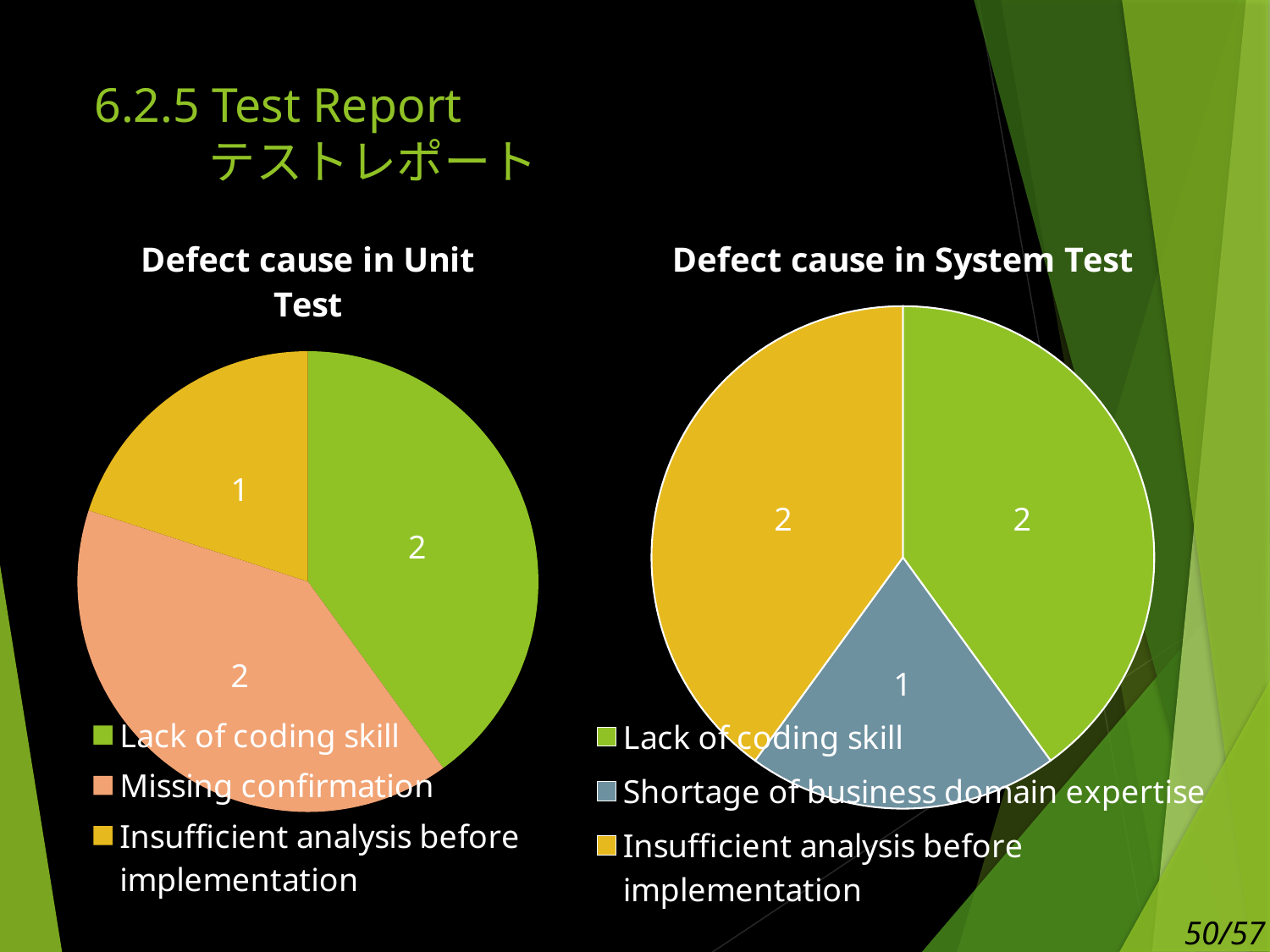
In the 'Defect cause in Unit Test' chart, what is the value for Lack of coding skill? 2 In the 'Defect cause in System Test' chart, what is the value for Shortage of business domain expertise? 1 In the 'Defect cause in Unit Test' chart, how many categories are shown? 3 In the 'Defect cause in Unit Test' chart, which colour represents Missing confirmation? Orange In the 'Defect cause in Unit Test' chart, what share of the total does Missing confirmation represent? 40% In the 'Defect cause in Unit Test' chart, what is the value for Insufficient analysis before implementation? 1 In the 'Defect cause in System Test' chart, which category has the smallest slice? Shortage of business domain expertise In the 'Defect cause in System Test' chart, what share of the total does Shortage of business domain expertise represent? 20% What type of chart is used for 'Defect cause in System Test'? Pie chart In the 'Defect cause in System Test' chart, what is the value for Insufficient analysis before implementation? 2 In the 'Defect cause in System Test' chart, what is the difference between Lack of coding skill and Shortage of business domain expertise? 1 In the 'Defect cause in Unit Test' chart, which category has the smallest slice? Insufficient analysis before implementation